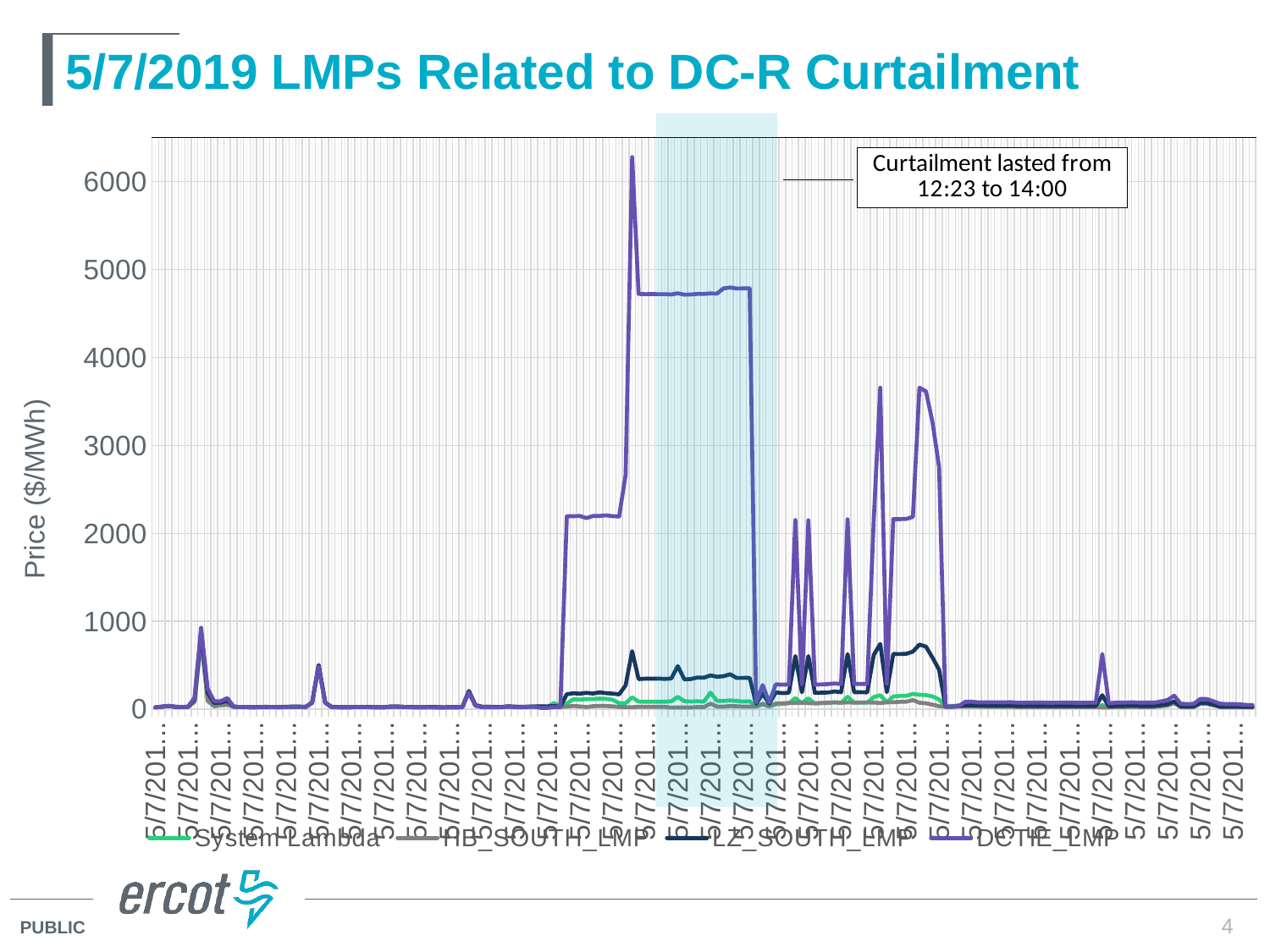
Is the highest value of the LZ_SOUTH_LMP series greater or less than 1000? less Is the highest value of the DCTIE_LMP series greater or less than 6000? greater According to the annotation on the chart, when did the curtailment last from and to? 12:23 to 14:00 How many series does the legend list? 4 What is the label of the vertical axis? Price ($/MWh) What kind of chart is shown on the slide? line chart Is the highest value of the System Lambda series greater or less than 1000? less Which series reaches the highest price on the chart? DCTIE_LMP